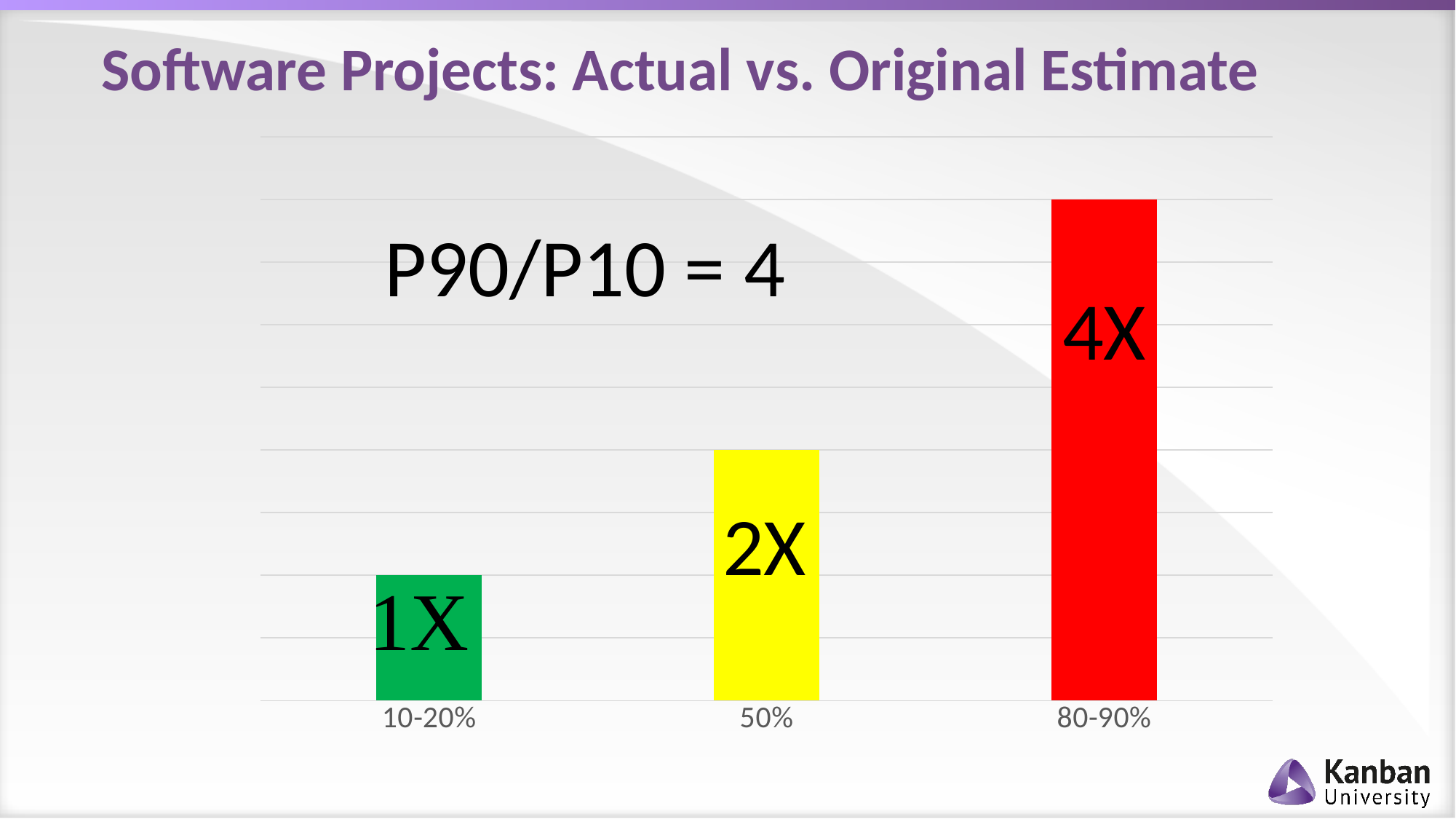
What kind of chart is shown on the slide? bar chart Do the values rise or fall from left to right along the x axis? rise What is the value for the 50% category? 2X What is the title of the slide containing the chart? Software Projects: Actual vs. Original Estimate What is the value for the 80-90% category? 4X What colour is the bar for the 80-90% category? red Which category has the highest value? 80-90% Which category has the lowest value? 10-20% How many categories are shown on the x axis? 3 Which is larger, the value for 50% or the value for 80-90%? 80-90% What ratio is stated in the text annotation on the chart? P90/P10 = 4 What is the value for the 10-20% category? 1X